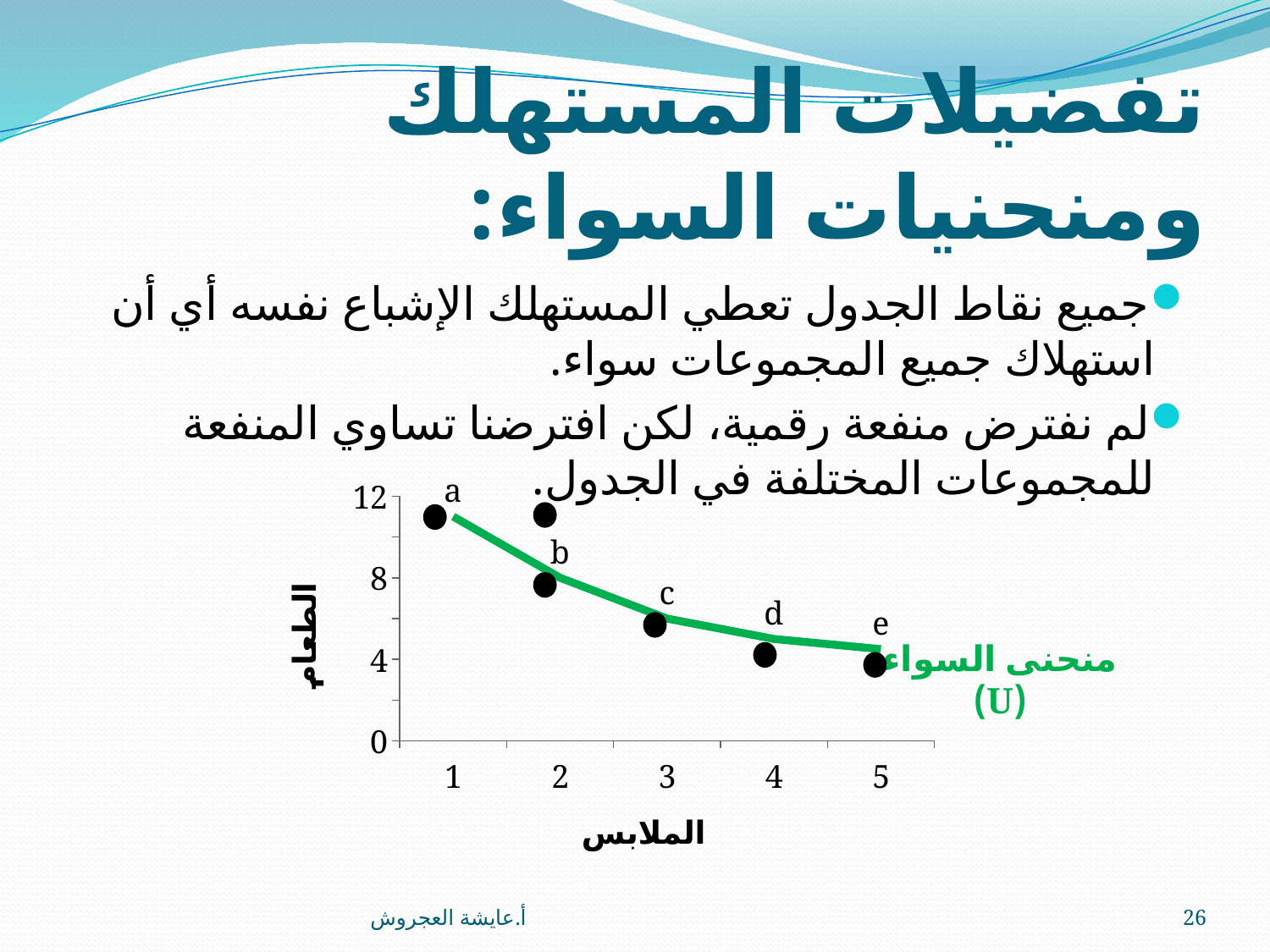
Is the value of الطعام at point b greater or less than 4? greater What is the label on the x axis of the chart? الملابس What is the highest tick value shown on the y axis? 12 Is the value of الطعام at point c greater or less than 8? less How many labeled points (a, b, c, d, e) are marked on the curve? 5 What is the label on the y axis of the chart? الطعام Is the value of الطعام at point e greater or less than 8? less Does the value of الطعام rise or fall as الملابس increases from 1 to 5? fall Which point has a higher value of الطعام, a or e? a Which labeled point has the highest value of الطعام? a